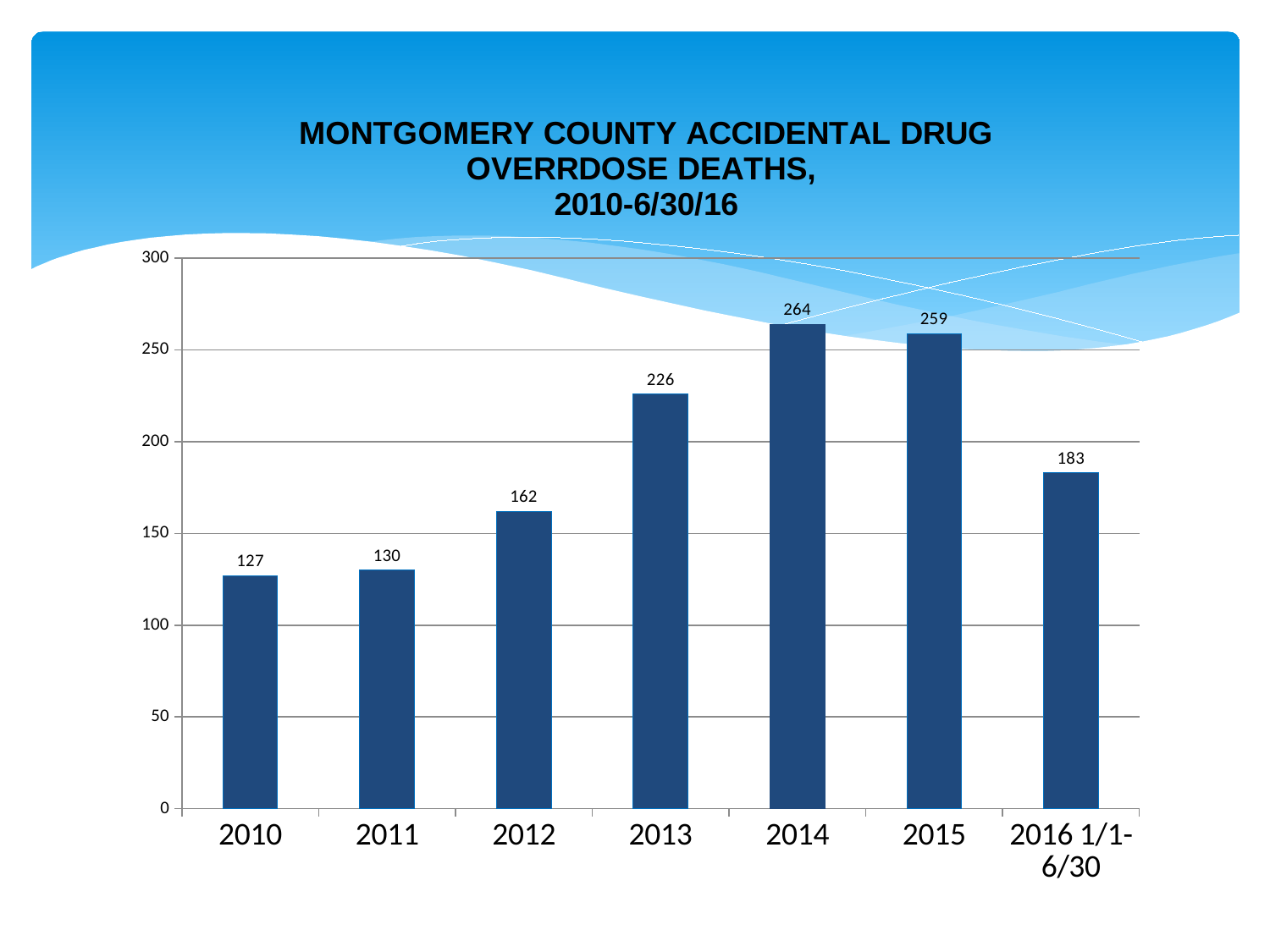
Is the value for 2015 greater or less than 250? greater What is the difference between the values for 2012 and 2011? 32 What kind of chart is shown on the slide? bar chart Which year has the highest value? 2014 What is the difference between the values for 2014 and 2015? 5 What is the value for 2016 1/1-6/30? 183 Do the values rise or fall from 2010 to 2014? rise What is the value for 2010? 127 What is the value for 2013? 226 Which category has the lowest value? 2010 Which is larger, the value for 2013 or the value for 2016 1/1-6/30? 2013 How many bars are shown in the chart? 7